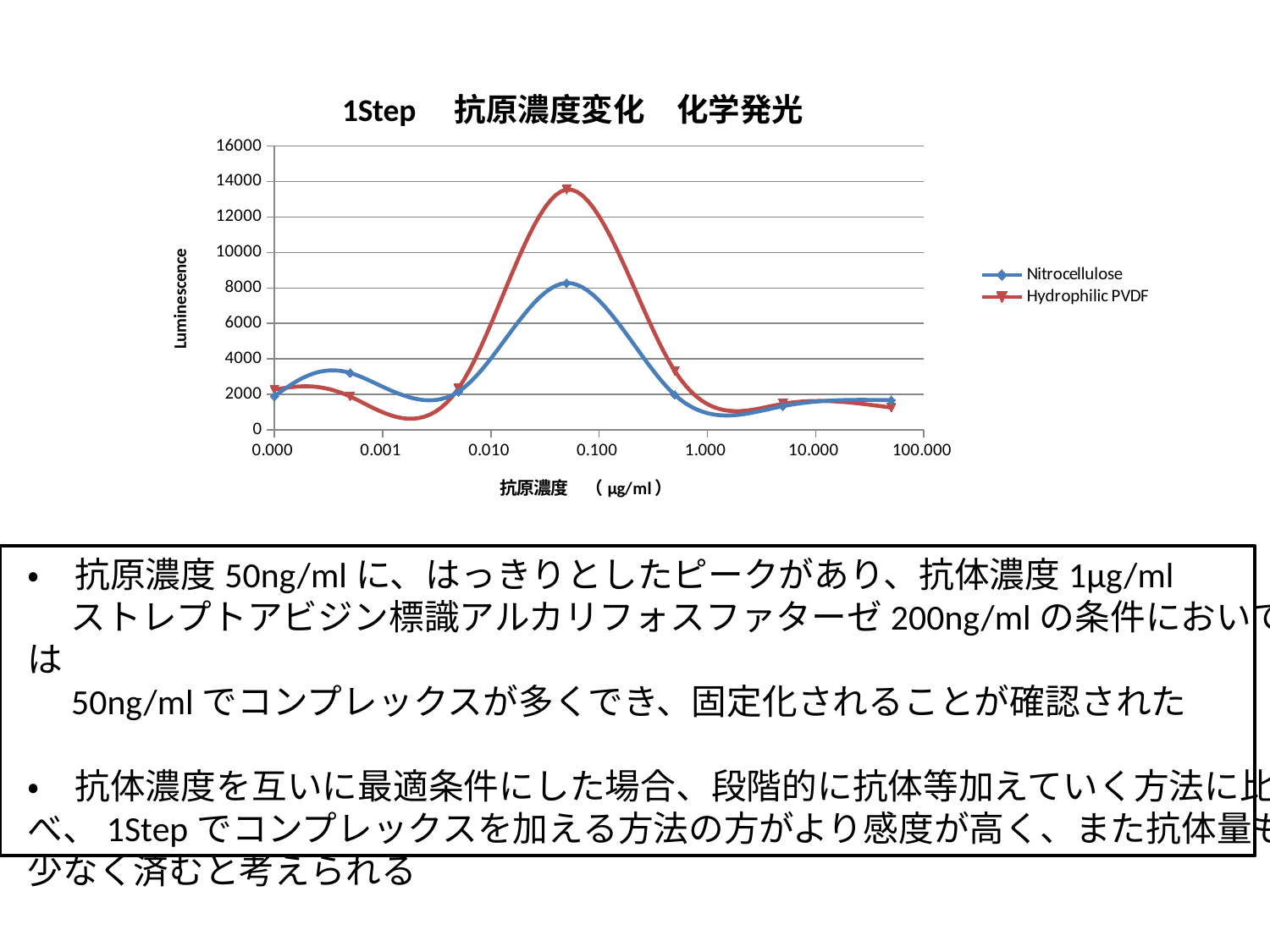
How many series does the legend list? 2 Is the peak value of the Hydrophilic PVDF series greater or less than 12000? greater What is the title of the vertical axis? Luminescence Is the Hydrophilic PVDF value at about 0.5 µg/ml greater or less than 2000? greater Which series reaches the higher peak luminescence? Hydrophilic PVDF At an antigen concentration of about 0.5 µg/ml, which series has the higher luminescence? Hydrophilic PVDF Between the peak near 0.05 µg/ml and the point near 0.5 µg/ml, do both series rise or fall? fall Is the peak value of the Nitrocellulose series greater or less than 6000? greater What are the two series named in the legend? Nitrocellulose and Hydrophilic PVDF What kind of chart is shown on the slide? line chart